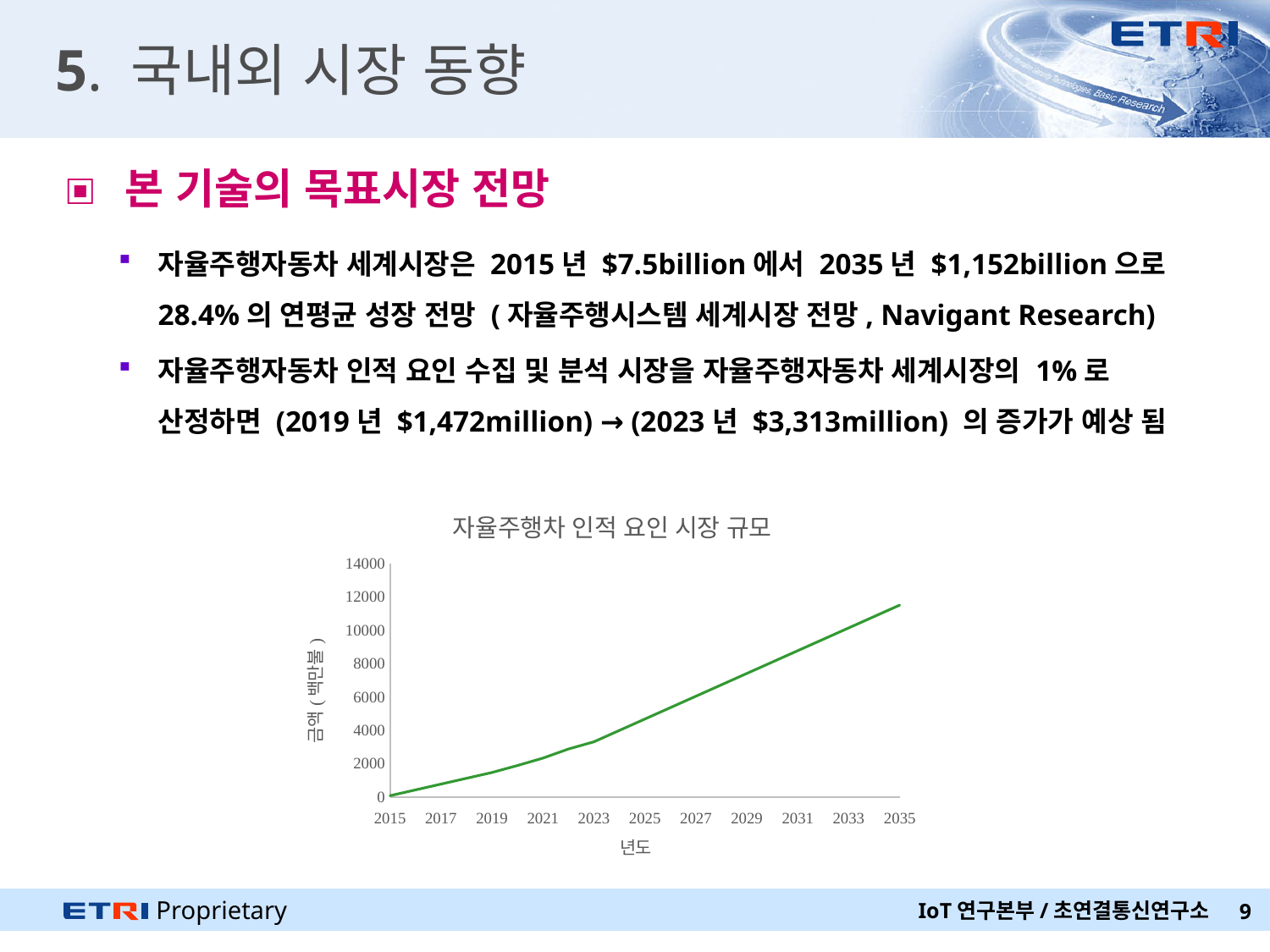
Is the value for 2015 greater or less than 2000? less Is the value for 2023 greater or less than 2000? greater What kind of chart is shown on the slide? line chart What is the title of the chart? 자율주행차 인적 요인 시장 규모 Do the values in the chart rise or fall from 2015 to 2035? rise Is the value for 2035 greater or less than 10000? greater How many year labels are shown on the x axis of the chart? 11 What is the label of the x axis of the chart? 년도 Which year has the highest value in the chart? 2035 Which year has the lowest value in the chart? 2015